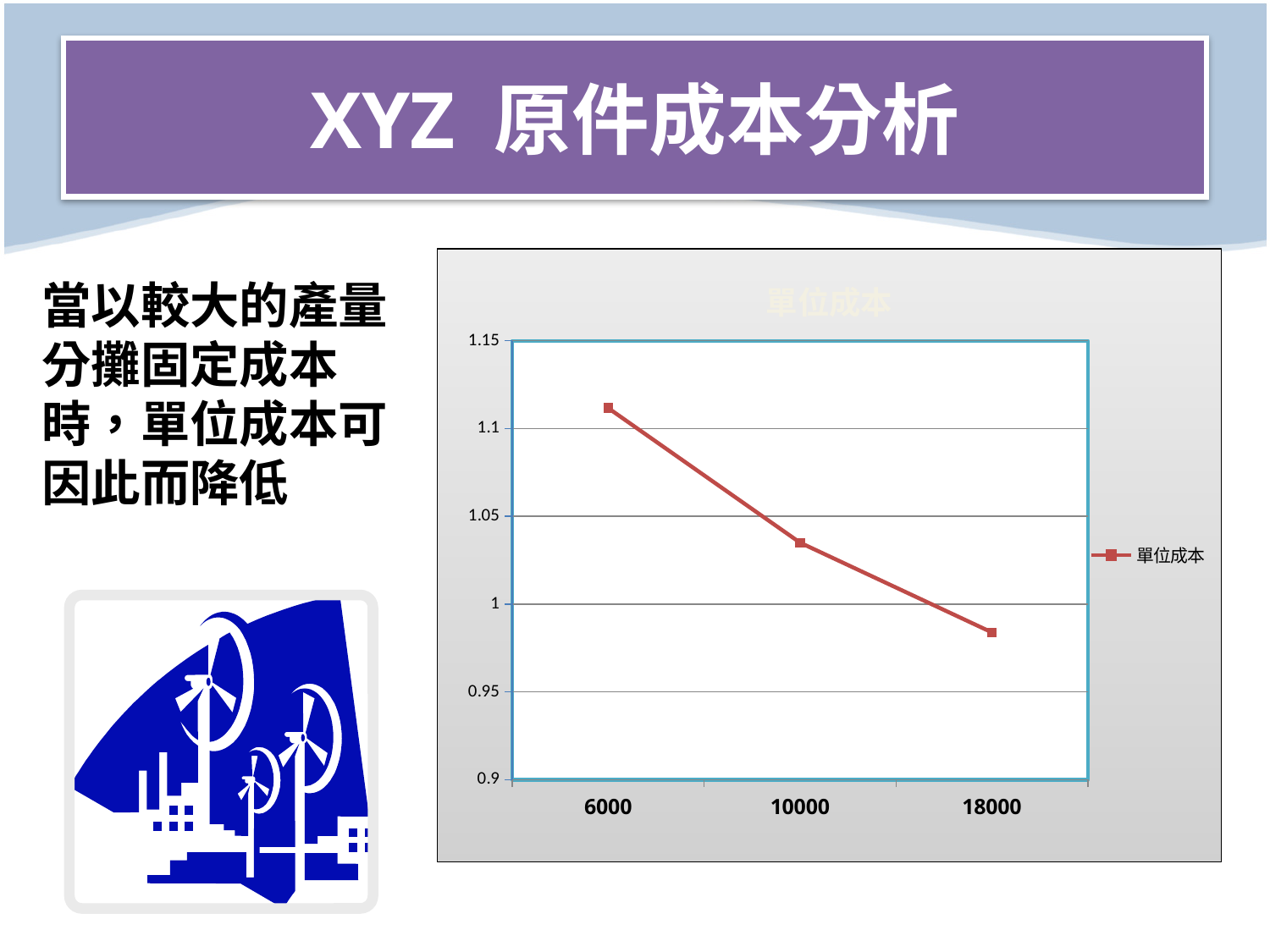
How many data points are plotted on the line chart? 3 What is the name of the series shown in the chart legend? 單位成本 Which has the larger value, 6000 or 10000? 6000 Is the value for 6000 greater or less than 1.1? greater Do the values rise or fall as the x axis goes from 6000 to 18000? fall What are the category labels shown on the x axis of the chart? 6000, 10000, 18000 Which x-axis category has the highest value? 6000 Which x-axis category has the lowest value? 18000 Is the value for 18000 greater or less than 1? less Is the value for 10000 greater or less than 1.05? less How many series does the legend of the chart list? 1 What kind of chart is shown on the slide? line chart